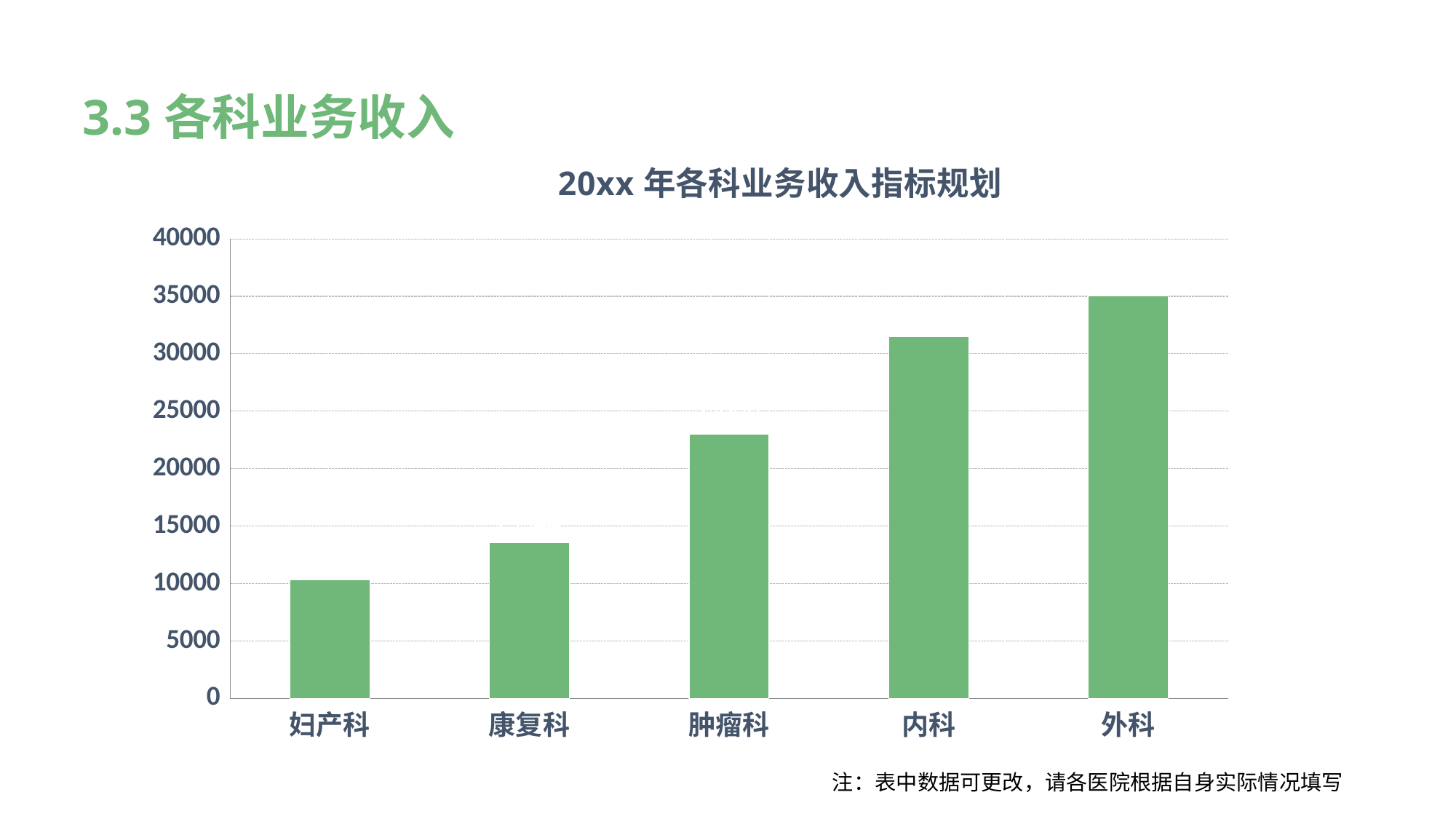
Which has a larger value, 康复科 or 妇产科? 康复科 How many departments (categories) are shown on the x axis of the chart? 5 What kind of chart is shown on the slide? bar chart Is the value for 内科 greater or less than 30000? greater Which has a larger value, 内科 or 肿瘤科? 内科 Is the value for 肿瘤科 greater or less than 20000? greater Which department has the lowest value in the chart? 妇产科 Is the value for 康复科 greater or less than 15000? less Do the values rise or fall from left to right along the x axis? rise What is the title of the chart? 20xx 年各科业务收入指标规划 Which department has the highest value in the chart? 外科